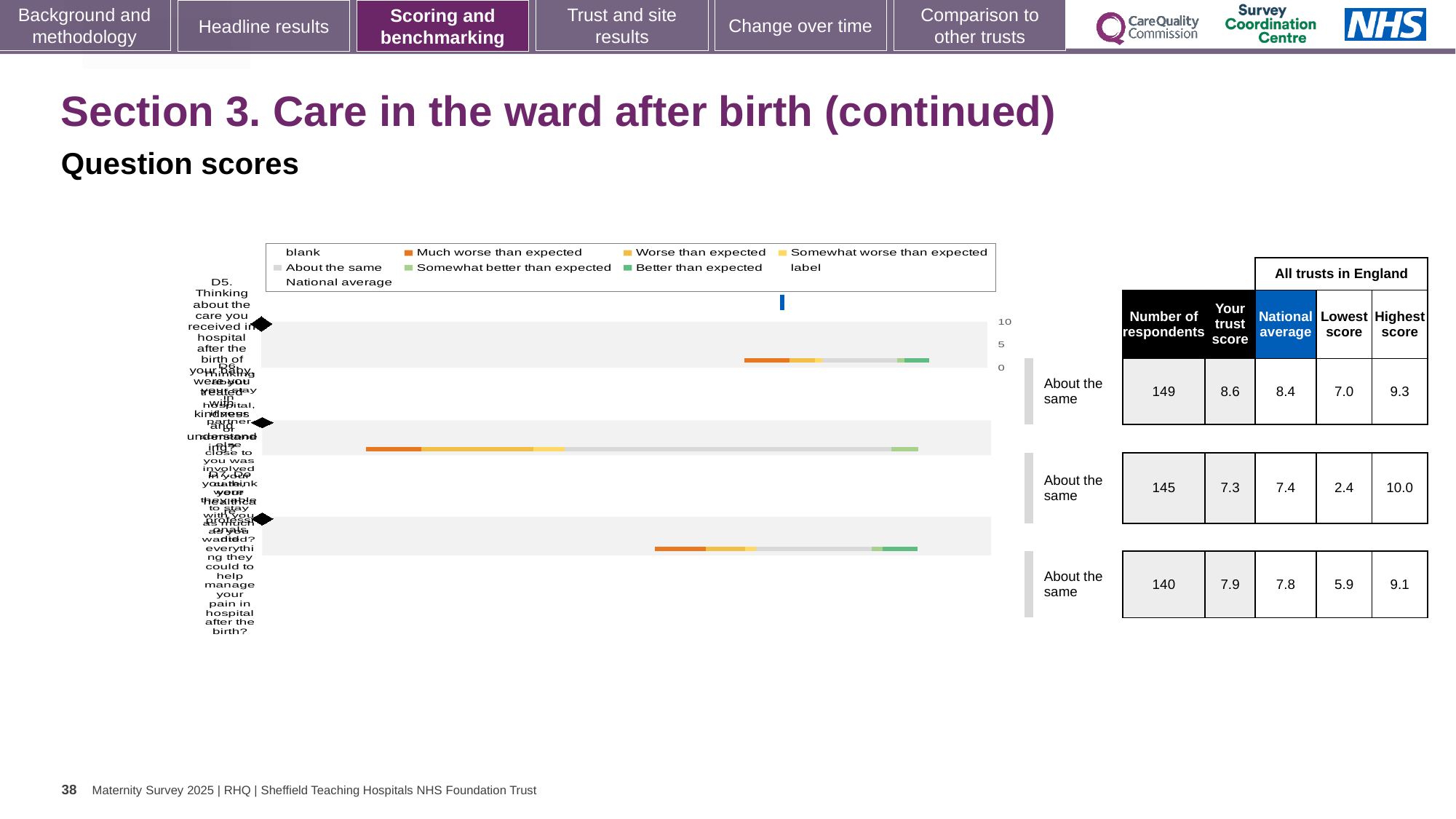
What colour does the legend use for 'Better than expected'? green In the table beside the chart, what is 'Your trust score' for question D6? 7.3 In the table beside the chart, what is the highest score across all trusts in England for question D6? 10.0 What kind of chart is shown on the slide? bar chart For question D5, what is the difference between your trust score and the national average? 0.2 In the table beside the chart, what is the number of respondents for question D5? 149 What colour does the legend use for 'Much worse than expected'? orange In the table beside the chart, what is the national average for question D7? 7.8 Which question has the highest number of respondents? D5 For question D5, which is larger: your trust score or the national average? your trust score In the table beside the chart, what is the lowest score across all trusts in England for question D6? 2.4 How many questions (bars) are plotted in the chart? 3